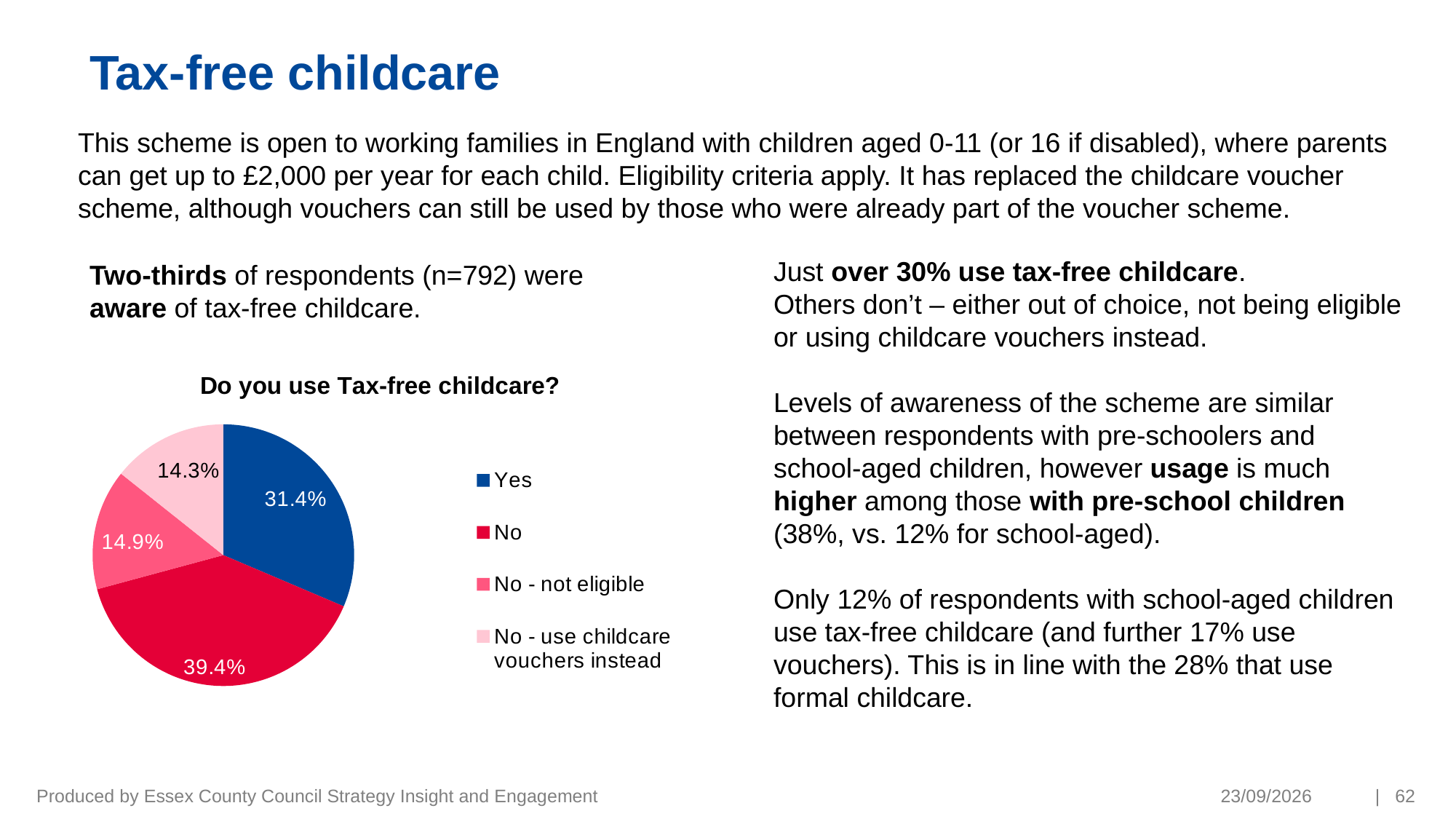
How many categories does the pie chart show? 4 What colour is the "Yes" slice? Dark blue What type of chart is shown on the slide? Pie chart What percentage of respondents answered "No - not eligible"? 14.9% What percentage of respondents answered "No - use childcare vouchers instead"? 14.3% Which response has the largest share of the pie? No Which response has the smallest share of the pie? No - use childcare vouchers instead What is the title of the chart? Do you use Tax-free childcare? What percentage of respondents answered "Yes"? 31.4% What percentage of respondents answered "No"? 39.4% What is the difference in percentage points between the "No" and "Yes" slices? 8.0 percentage points Which is larger, the "Yes" slice or the "No - not eligible" slice? Yes